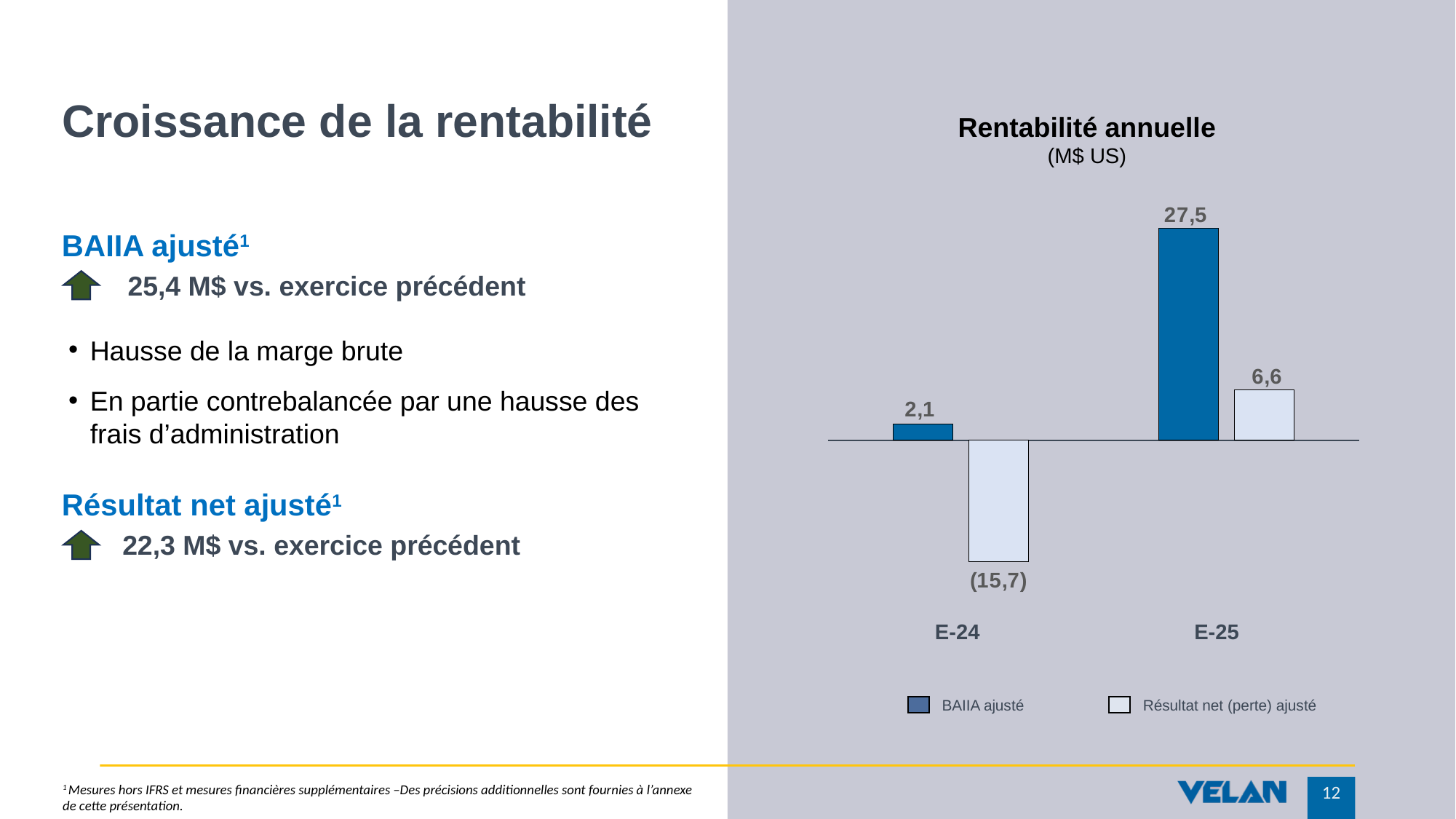
How many series does the chart legend list? 2 How many years are shown on the x axis of the chart? 2 What type of chart is shown on the slide? Bar chart By how much did Résultat net (perte) ajusté increase from E-24 to E-25? 22,3 What is the value of BAIIA ajusté for E-25? 27,5 What is the value of BAIIA ajusté for E-24? 2,1 What is the value of Résultat net (perte) ajusté for E-25? 6,6 Which bar in the chart shows the highest value? BAIIA ajusté for E-25 What is the value of Résultat net (perte) ajusté for E-24? (15,7) By how much did BAIIA ajusté increase from E-24 to E-25? 25,4 Which bar in the chart shows the lowest value? Résultat net (perte) ajusté for E-24 Which year has the higher BAIIA ajusté, E-24 or E-25? E-25